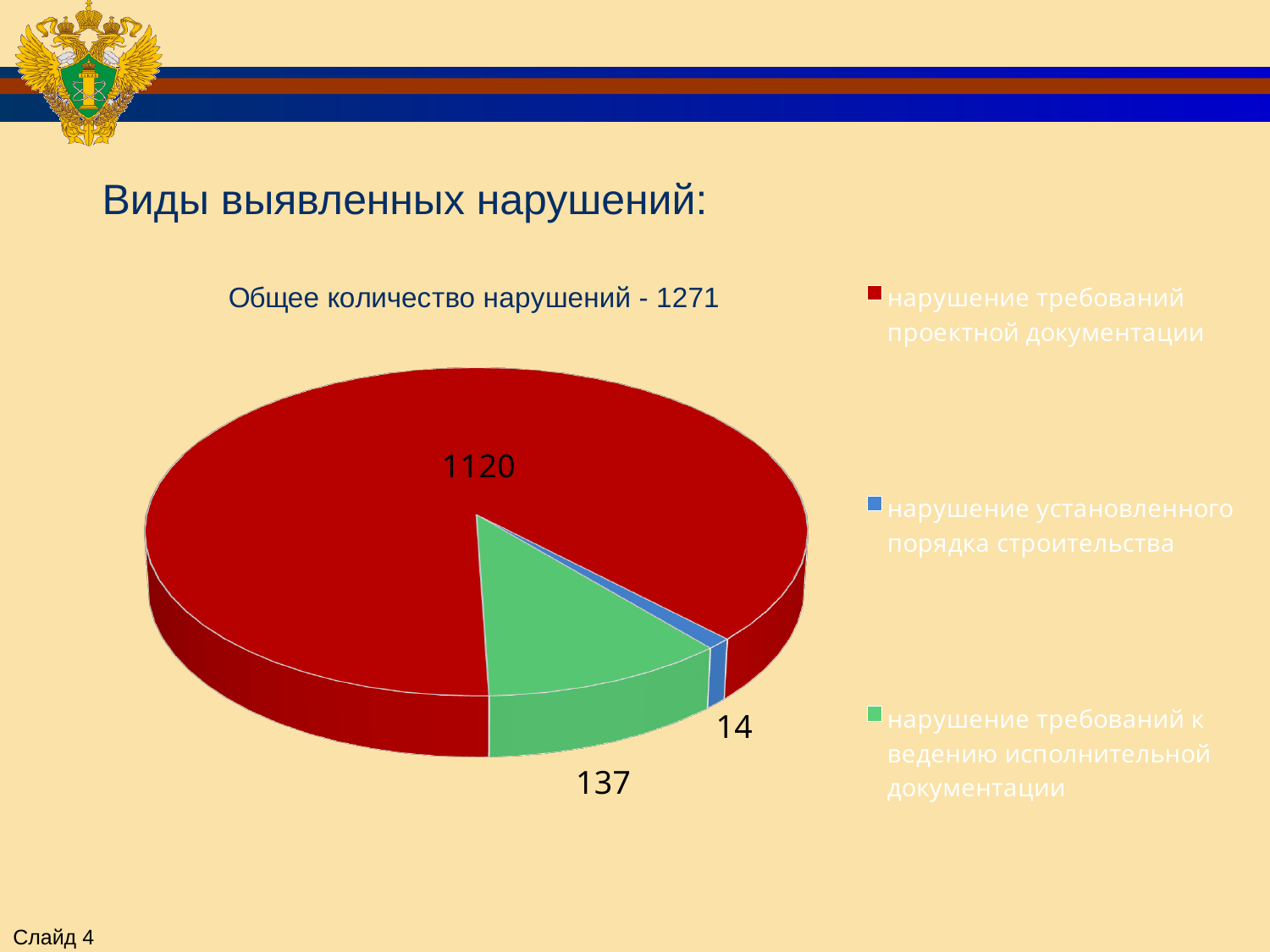
How many entries does the legend list? 3 What is the title of the chart? Общее количество нарушений - 1271 What type of chart is shown on the slide? pie chart Which category has the largest slice of the pie? нарушение требований проектной документации What is the value for 'нарушение установленного порядка строительства'? 14 What is the value for 'нарушение требований проектной документации'? 1120 Which is larger: the value for 'нарушение требований к ведению исполнительной документации' or for 'нарушение установленного порядка строительства'? нарушение требований к ведению исполнительной документации What is the difference between the values for 'нарушение требований проектной документации' and 'нарушение требований к ведению исполнительной документации'? 983 What colour is the slice for 'нарушение установленного порядка строительства'? blue How many slices does the pie chart have? 3 Which category has the smallest slice of the pie? нарушение установленного порядка строительства What is the value for 'нарушение требований к ведению исполнительной документации'? 137